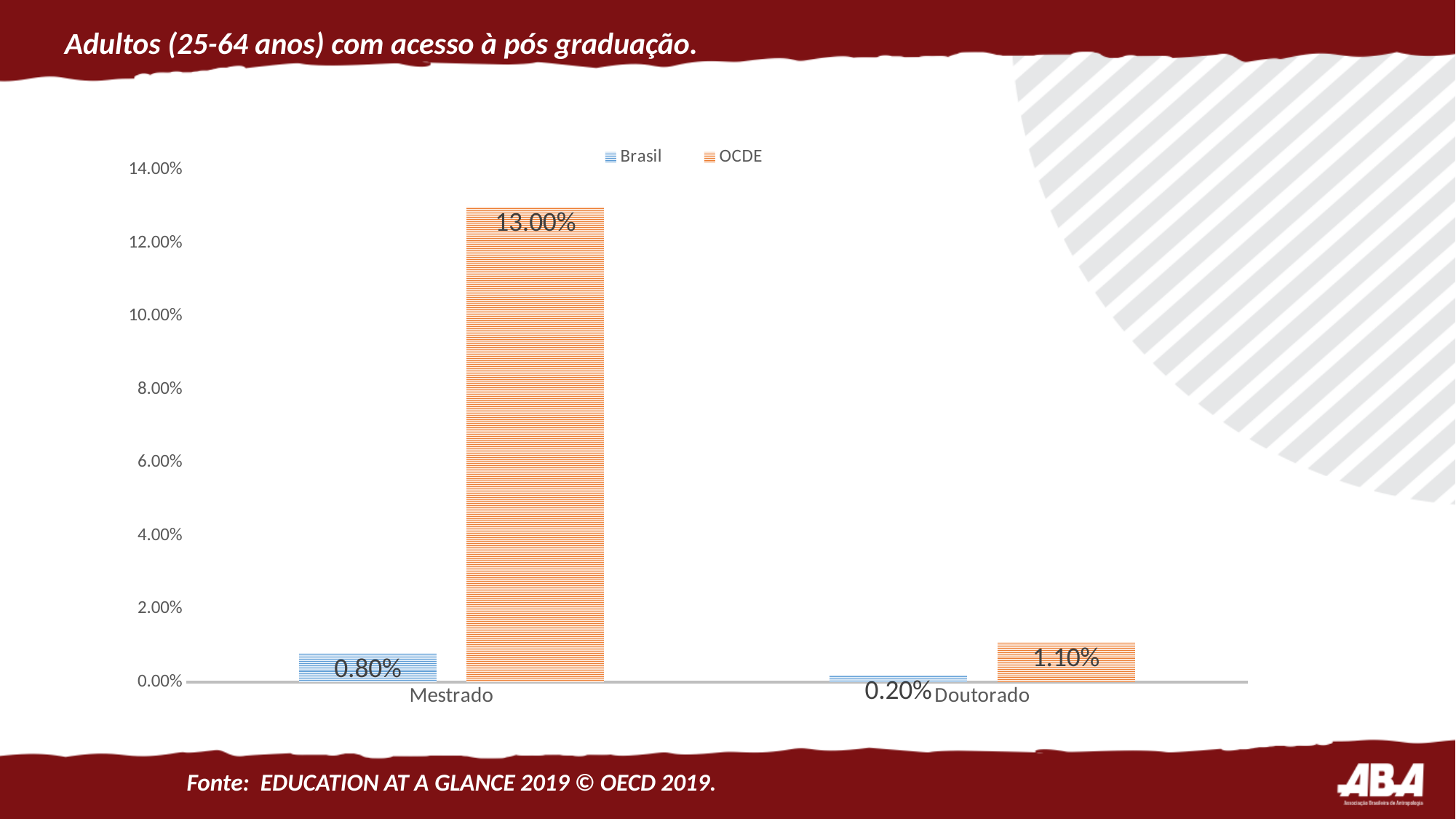
What kind of chart is shown on the slide? Bar chart How many categories are shown on the x axis? 2 What is the difference between the OCDE and Brasil values for Mestrado? 12.20% Which is larger for Doutorado, the Brasil value or the OCDE value? OCDE Which category has the highest OCDE value? Mestrado How many series does the legend list? 2 What is the value for Brasil in the Mestrado category? 0.80% What is the value for OCDE in the Mestrado category? 13.00% Which category has the lowest Brasil value? Doutorado What is the difference between the OCDE and Brasil values for Doutorado? 0.90% What is the value for Brasil in the Doutorado category? 0.20% What is the value for OCDE in the Doutorado category? 1.10%